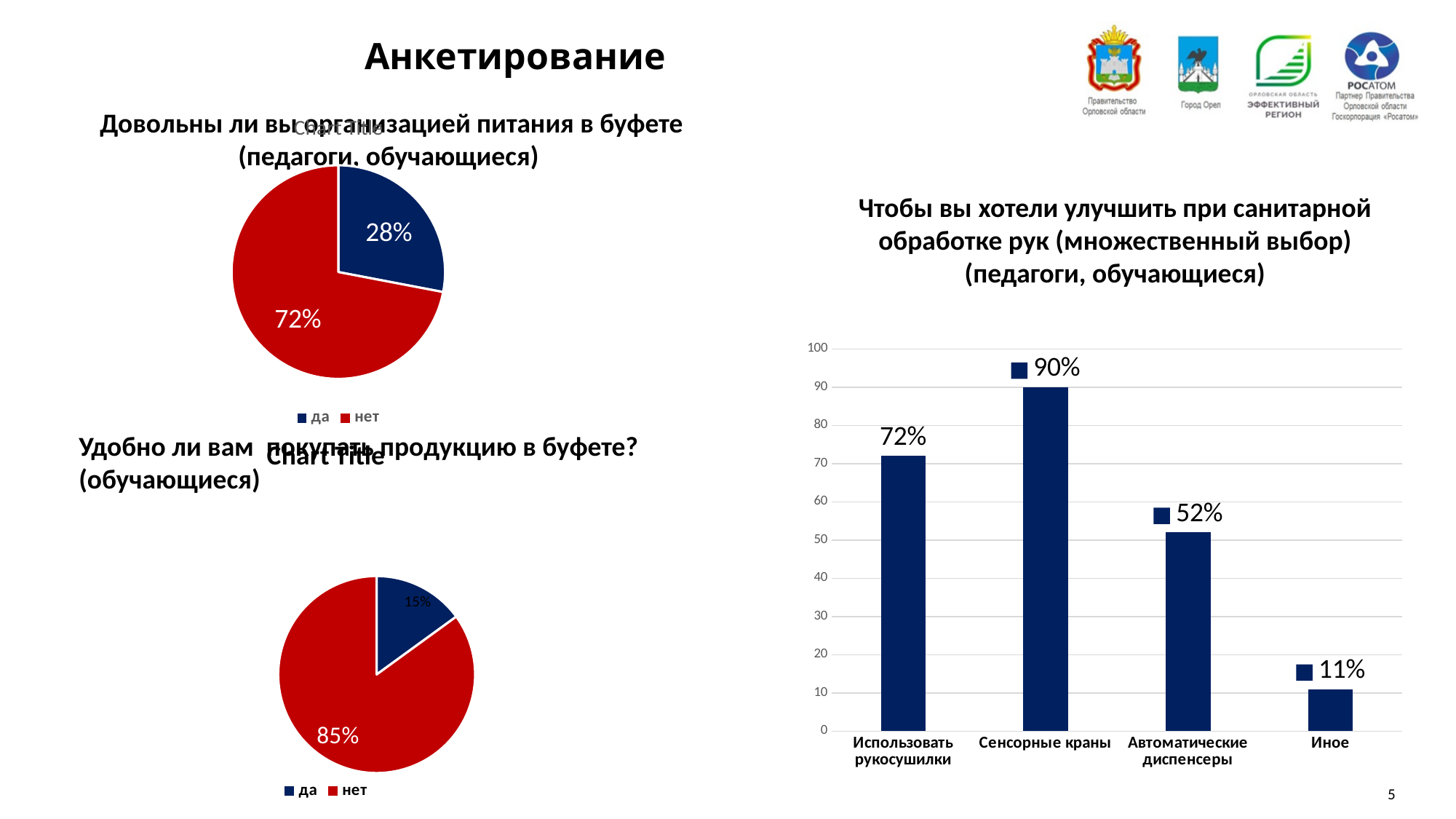
In the bottom-left pie chart, what is the difference between the "нет" and "да" shares? 70% In the top-left pie chart (Довольны ли вы организацией питания в буфете), what share of respondents answered "да"? 28% In the bar chart on the right, what is the difference between "Использовать рукосушилки" and "Автоматические диспенсеры"? 20% How many categories are shown in the bar chart on the right? 4 In the bar chart on the right, which category has the highest value? Сенсорные краны In the bottom-left pie chart (Удобно ли вам покупать продукцию в буфете?), what share of respondents answered "нет"? 85% In the top-left pie chart, which answer has the larger slice, "да" or "нет"? нет In the bar chart on the right, what is the value for "Сенсорные краны"? 90% In the bar chart on the right, which category has the lowest value? Иное In the top-left pie chart (Довольны ли вы организацией питания в буфете), what share of respondents answered "нет"? 72% What type of chart is the chart on the right side of the slide (Чтобы вы хотели улучшить при санитарной обработке рук)? bar chart In the bottom-left pie chart (Удобно ли вам покупать продукцию в буфете?), what share of respondents answered "да"? 15%